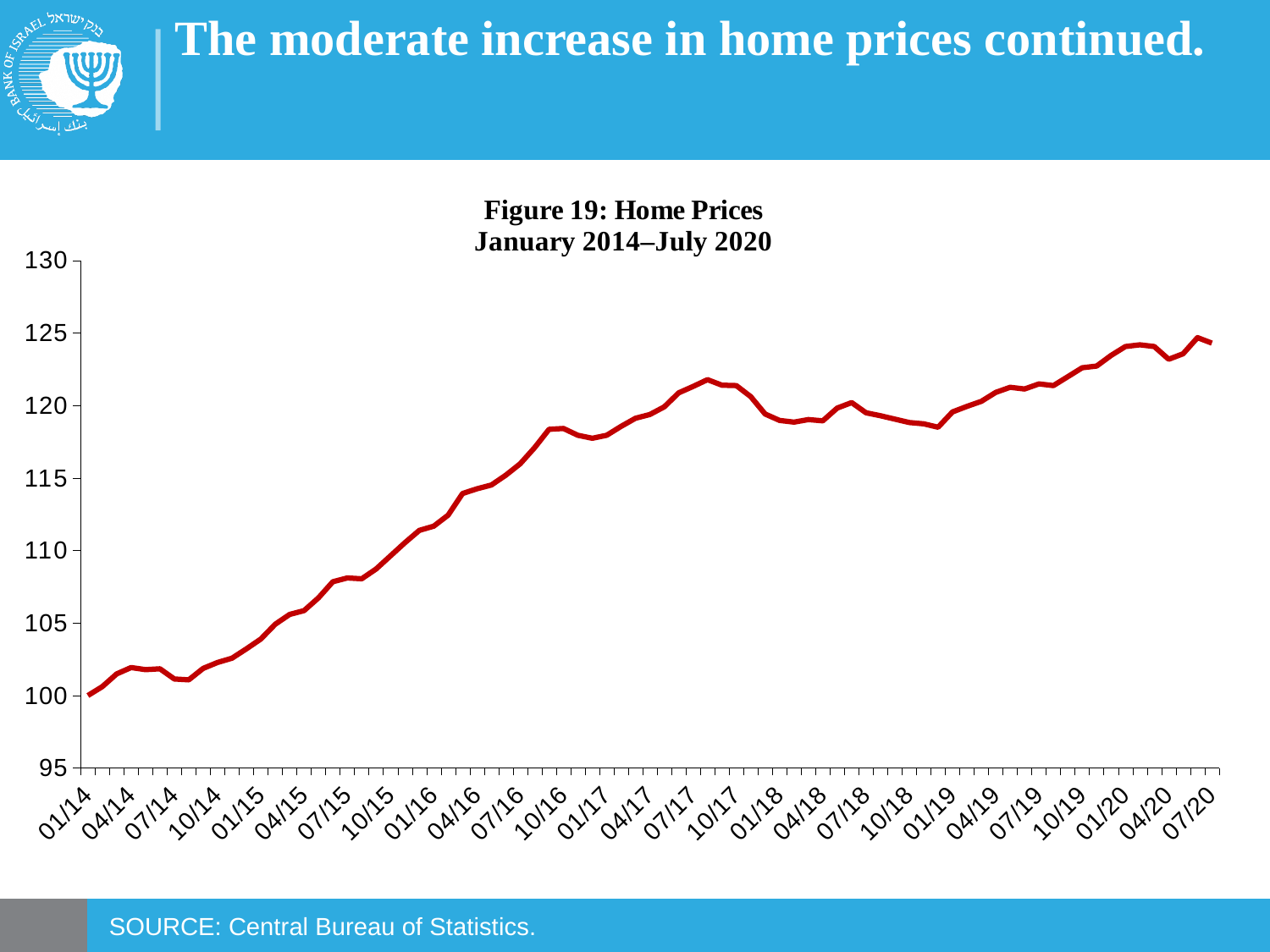
Which point on the x axis has the lowest home price value? 01/14 What kind of chart is shown on the slide? line chart Which is larger, the value at 07/17 or the value at 01/18? 07/17 Is the value for 07/15 greater or less than 110? less What is the title of the chart? Figure 19: Home Prices January 2014–July 2020 Which is larger, the value at 01/14 or the value at 07/20? 07/20 Do home prices generally rise or fall from 01/14 to 07/20? rise Is the value for 07/20 greater or less than 120? greater Is the value for 07/14 greater or less than 105? less What is the value of the home price index at 01/14? 100 What source is cited for the chart? Central Bureau of Statistics